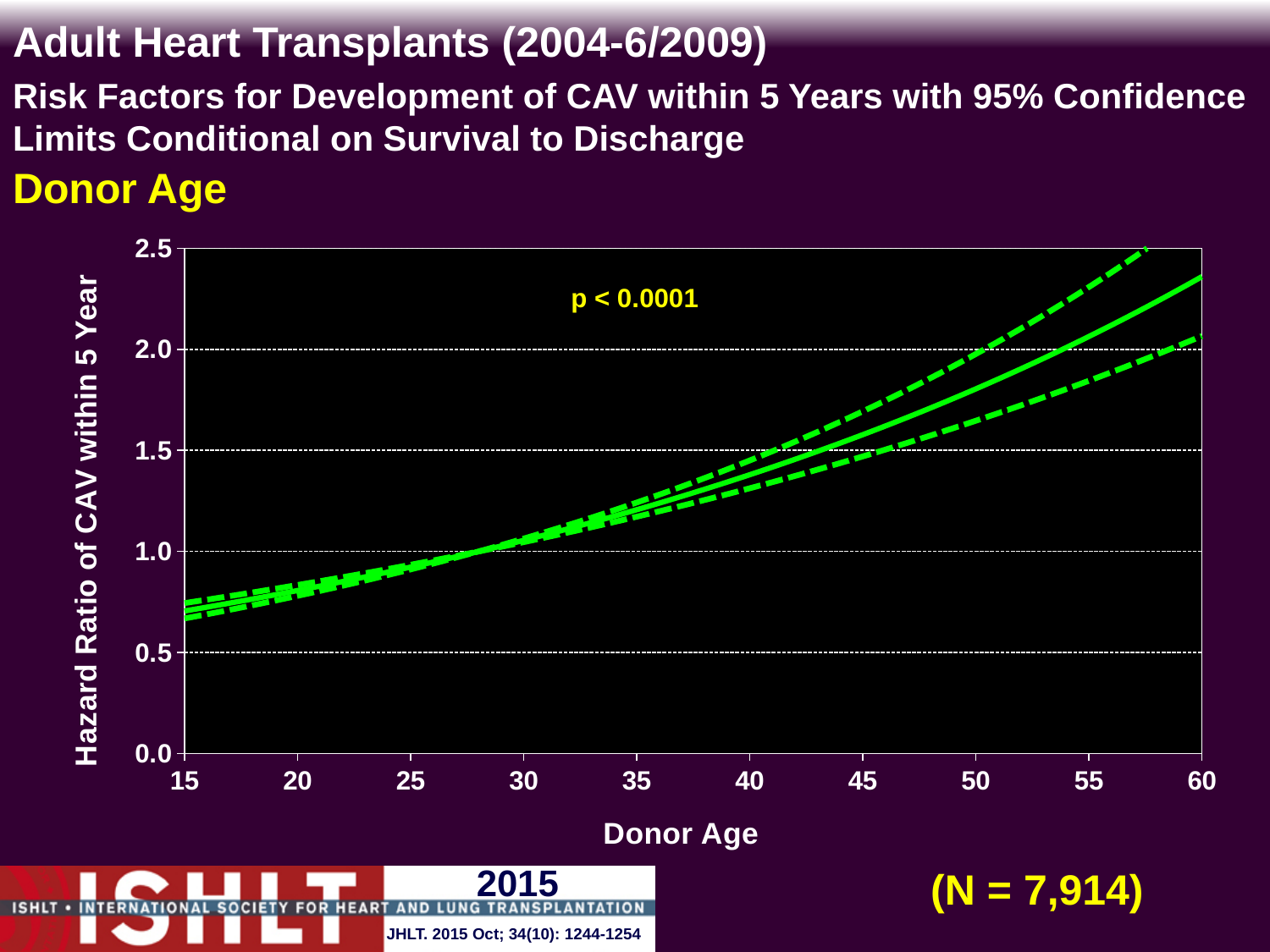
Is the hazard ratio on the solid line at donor age 20 greater or less than 1.0? less What p-value is printed on the chart? p < 0.0001 Does the hazard ratio of CAV within 5 years rise or fall as donor age increases from 15 to 60? rise Is the hazard ratio on the solid line at donor age 50 greater or less than 1.5? greater Which donor age has the higher hazard ratio on the solid line, 30 or 55? 55 Is the hazard ratio on the solid line at donor age 60 greater or less than 2.0? greater What kind of chart is shown on the slide? line chart How many lines (solid and dashed) are plotted on the chart? 3 What is the maximum value shown on the y axis of the chart? 2.5